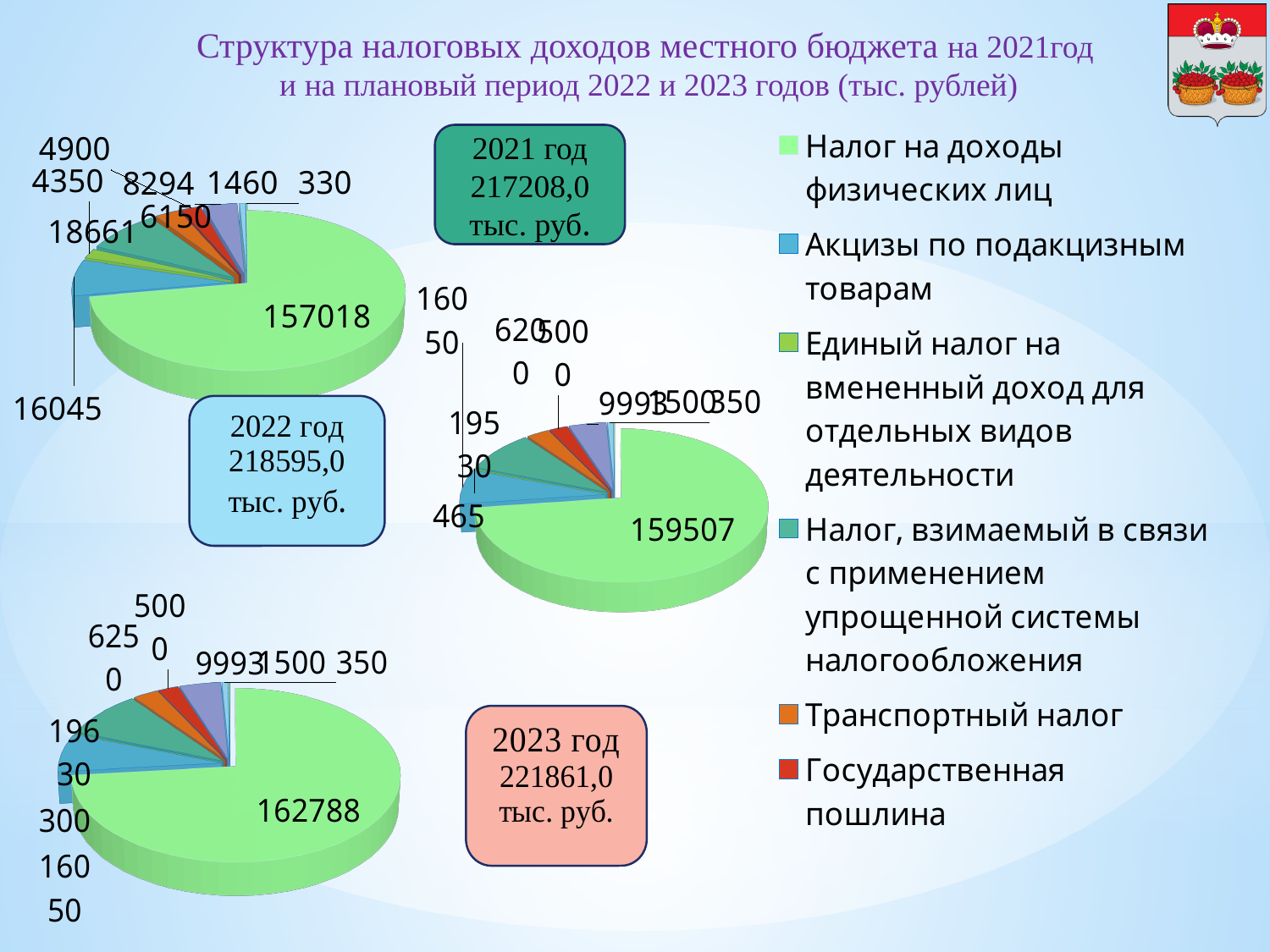
In the 2021 pie chart, what is the value of the largest slice? 157018 Which year's pie chart has the larger value for its largest slice, 2021 or 2023? 2023 Does the value of the largest slice rise or fall from the 2021 chart to the 2023 chart? Rises What kind of charts are shown on the slide? Pie charts How many categories does the legend on the right list? 6 What is the difference between the largest slice in the 2023 pie chart (162788) and the largest slice in the 2021 pie chart (157018)? 5770 What total is shown in the box for 2023? 221861,0 тыс. руб. What is the difference between the largest slice in the 2022 pie chart (159507) and the largest slice in the 2021 pie chart (157018)? 2489 In the 2021 pie chart, which legend category does the largest slice belong to? Налог на доходы физических лиц What total is shown in the box for 2021? 217208,0 тыс. руб. In the 2023 pie chart, what is the value of the largest slice? 162788 In the 2022 pie chart, what is the value of the largest slice? 159507